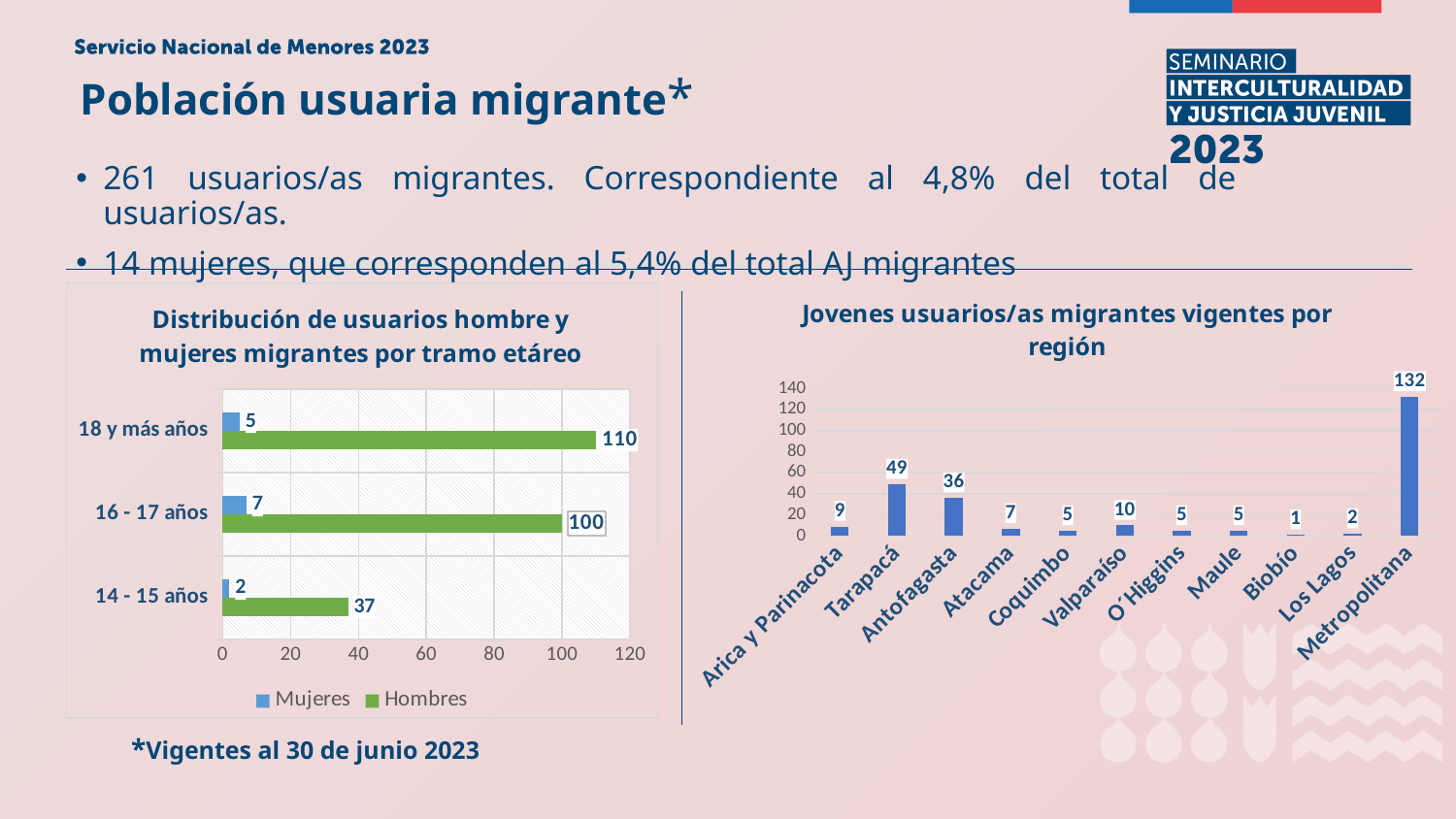
In the chart 'Jovenes usuarios/as migrantes vigentes por región', which region has the lowest value? Biobío In the chart 'Jovenes usuarios/as migrantes vigentes por región', which region has the highest value? Metropolitana In the chart 'Distribución de usuarios hombre y mujeres migrantes por tramo etáreo', how many series does the legend list? 2 In the chart 'Jovenes usuarios/as migrantes vigentes por región', what is the value for Metropolitana? 132 In the chart 'Jovenes usuarios/as migrantes vigentes por región', what is the difference between Tarapacá and Antofagasta? 13 What kind of chart is 'Distribución de usuarios hombre y mujeres migrantes por tramo etáreo'? Bar chart In the chart 'Jovenes usuarios/as migrantes vigentes por región', which is larger, Valparaíso or Atacama? Valparaíso In the chart 'Distribución de usuarios hombre y mujeres migrantes por tramo etáreo', what is the Hombres value for 16 - 17 años? 100 In the chart 'Distribución de usuarios hombre y mujeres migrantes por tramo etáreo', what is the Mujeres value for 14 - 15 años? 2 In the chart 'Jovenes usuarios/as migrantes vigentes por región', how many regions are shown? 11 In the chart 'Distribución de usuarios hombre y mujeres migrantes por tramo etáreo', what is the difference between Hombres and Mujeres for 18 y más años? 105 In the chart 'Jovenes usuarios/as migrantes vigentes por región', what is the value for Tarapacá? 49